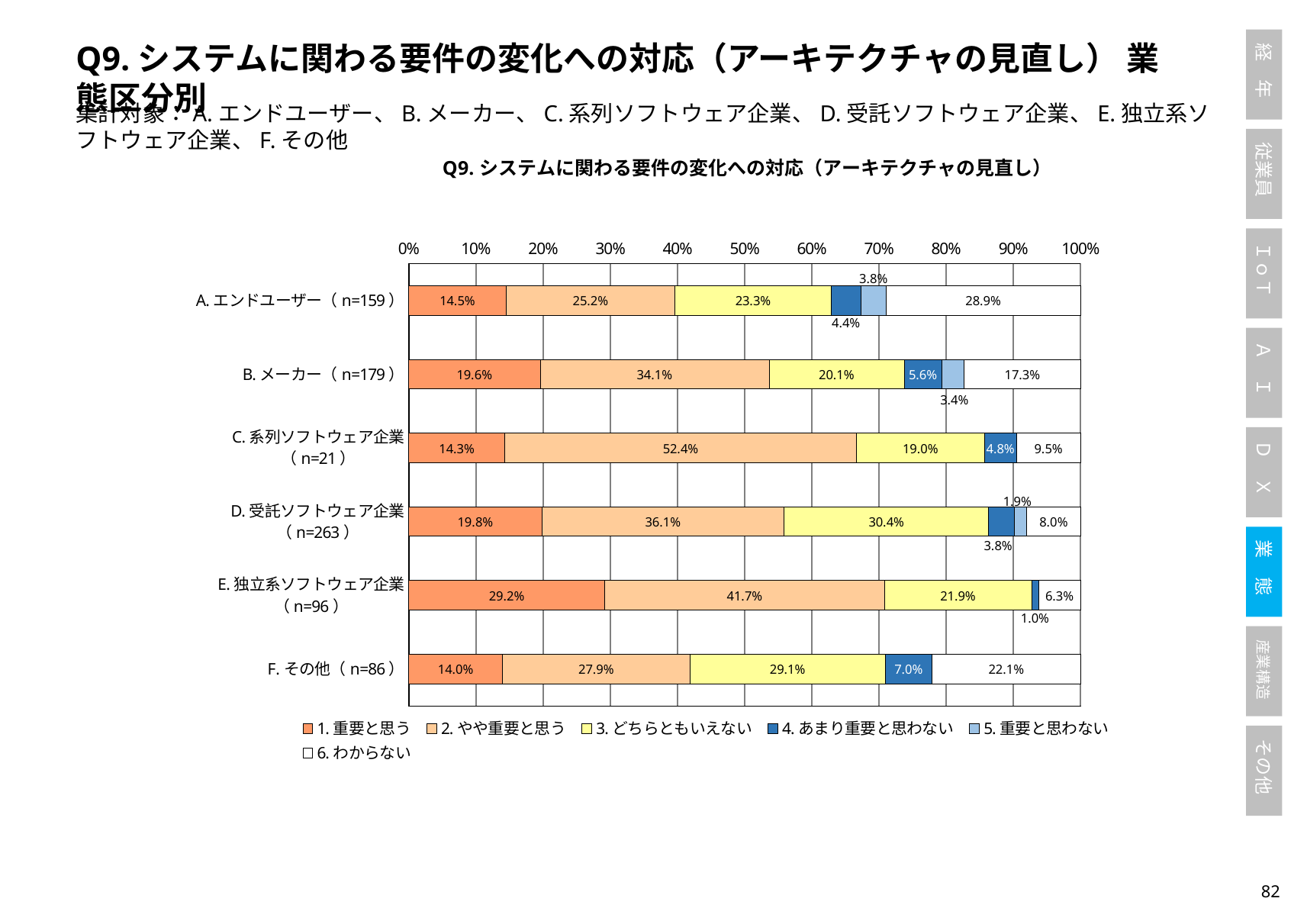
What is the value for 1. 重要と思う for A. エンドユーザー (n=159)? 14.5% How many categories are shown on the chart? 6 How many series does the legend list? 6 Which category has the highest value for 3. どちらともいえない? D. 受託ソフトウェア企業 (n=263) Which category has the highest value for 1. 重要と思う? E. 独立系ソフトウェア企業 (n=96) What is the title of the chart? Q9. システムに関わる要件の変化への対応（アーキテクチャの見直し） What kind of chart is shown on the slide? Stacked bar chart What is the difference between the 1. 重要と思う values for D. 受託ソフトウェア企業 and F. その他? 5.8 percentage points What is the value for 4. あまり重要と思わない for F. その他 (n=86)? 7.0% Which category has the lowest value for 6. わからない? E. 独立系ソフトウェア企業 (n=96) What is the value for 2. やや重要と思う for C. 系列ソフトウェア企業 (n=21)? 52.4% Which has the larger value for 2. やや重要と思う: B. メーカー or D. 受託ソフトウェア企業? D. 受託ソフトウェア企業